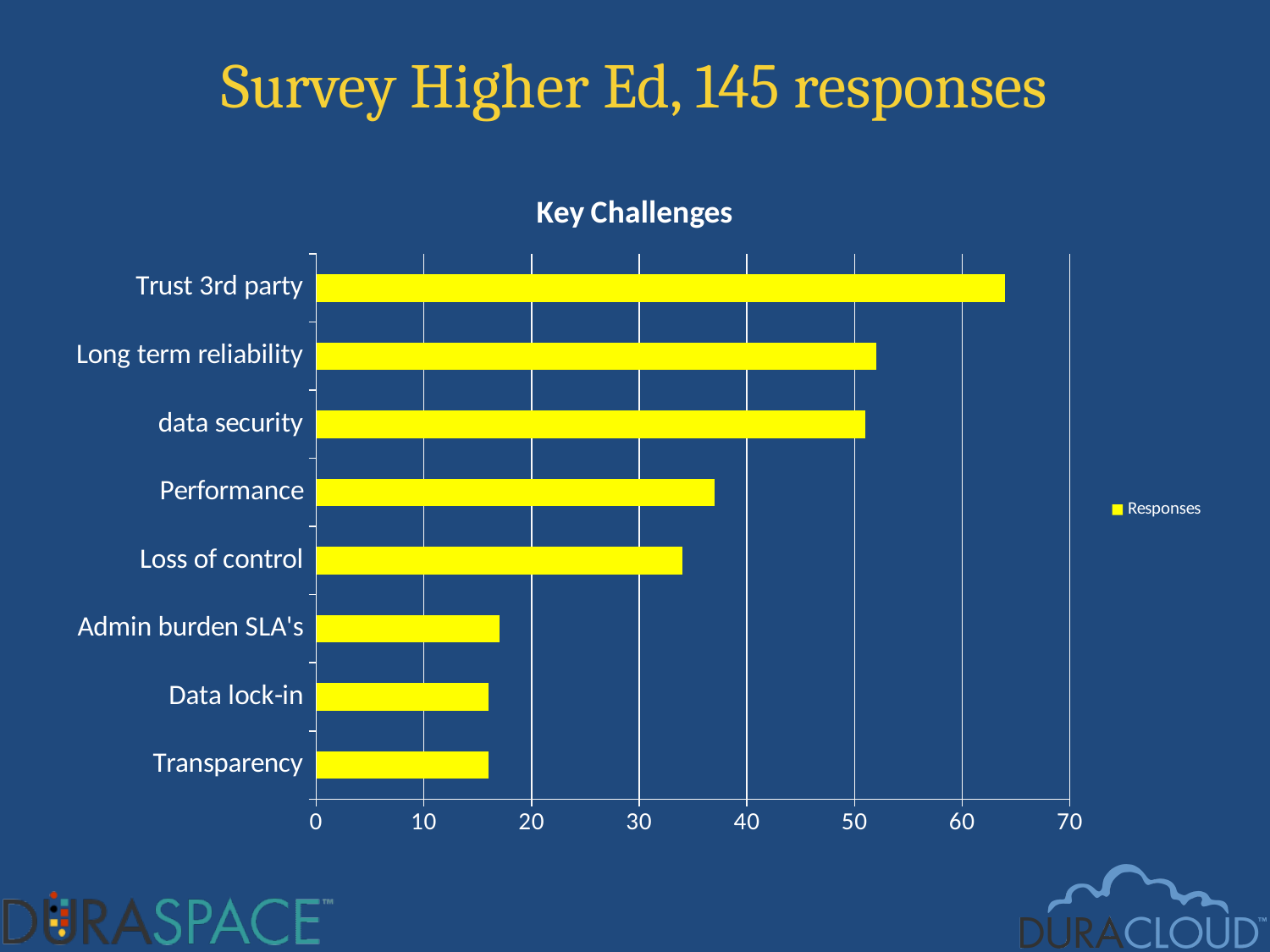
Is the value for Long term reliability greater or less than 50? greater Is the value for Trust 3rd party greater or less than 60? greater What type of chart is shown under the title "Key Challenges"? bar chart Is the value for Performance greater or less than 40? less How many series does the legend list? 1 What is the title of the chart? Key Challenges Which challenge has the highest number of responses? Trust 3rd party Which has more responses, Performance or Admin burden SLA's? Performance How many challenge categories are plotted in the chart? 8 What is the name of the series shown in the legend? Responses